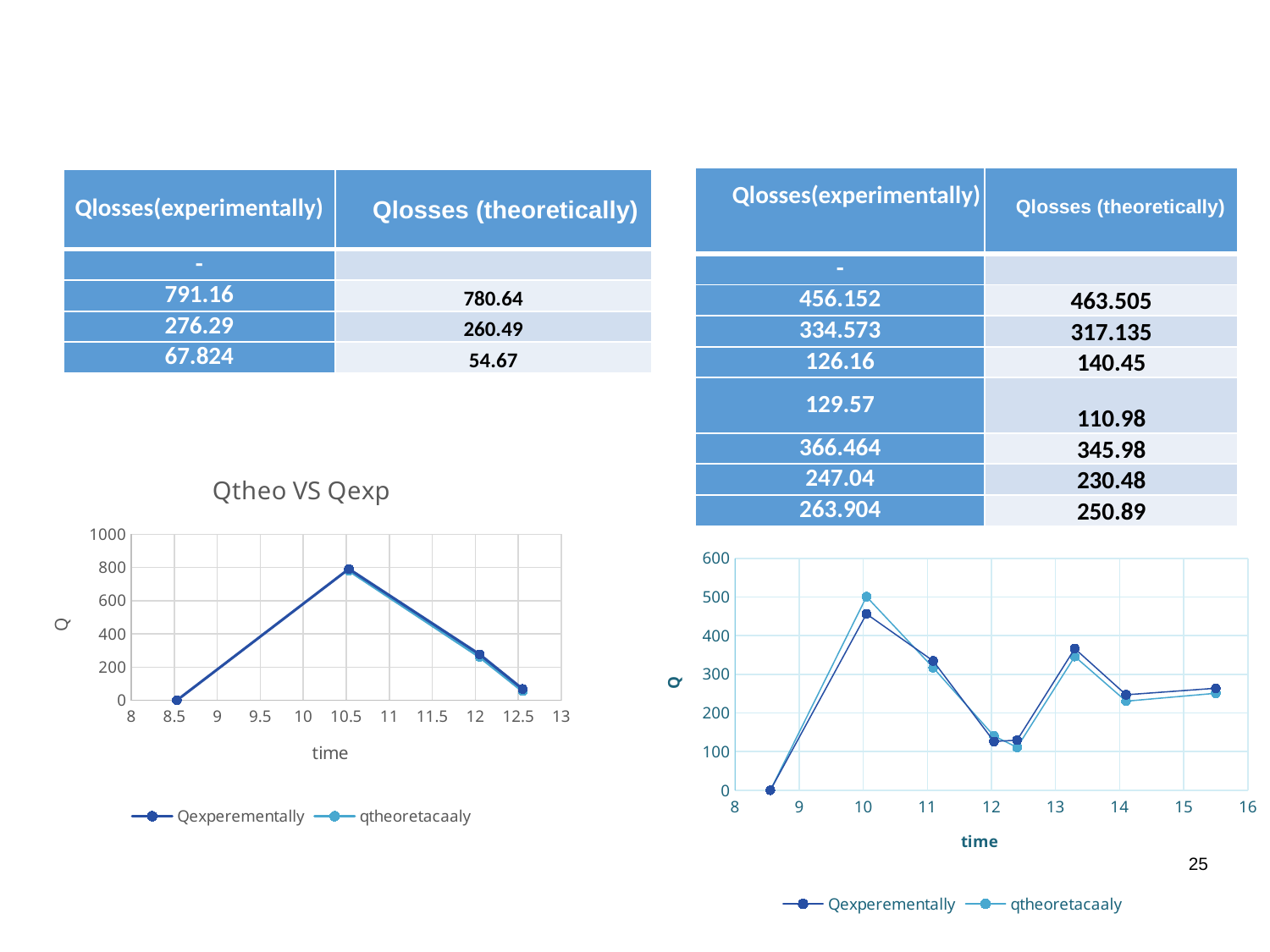
How many series does the legend of the left chart "Qtheo VS Qexp" list? 2 In the left chart "Qtheo VS Qexp", do the values rise or fall between time 10.5 and time 12.5? fall In the right chart, at time 10, which series has the higher value, Qexperementally or qtheoretacaaly? qtheoretacaaly How many data points are plotted for each series in the right chart? 8 In the left chart "Qtheo VS Qexp", is the Qexperementally value at time 10.5 greater or less than 600? greater What is the label of the y axis on the left chart "Qtheo VS Qexp"? Q What is the label of the x axis on the right chart? time In the left chart "Qtheo VS Qexp", is the Qexperementally value at time 12.5 greater or less than 200? less What type of chart is the left chart titled "Qtheo VS Qexp"? line chart In the left chart "Qtheo VS Qexp", at which time value do both series reach their highest point? 10.5 In the right chart, is the qtheoretacaaly value at time 10 greater or less than 400? greater